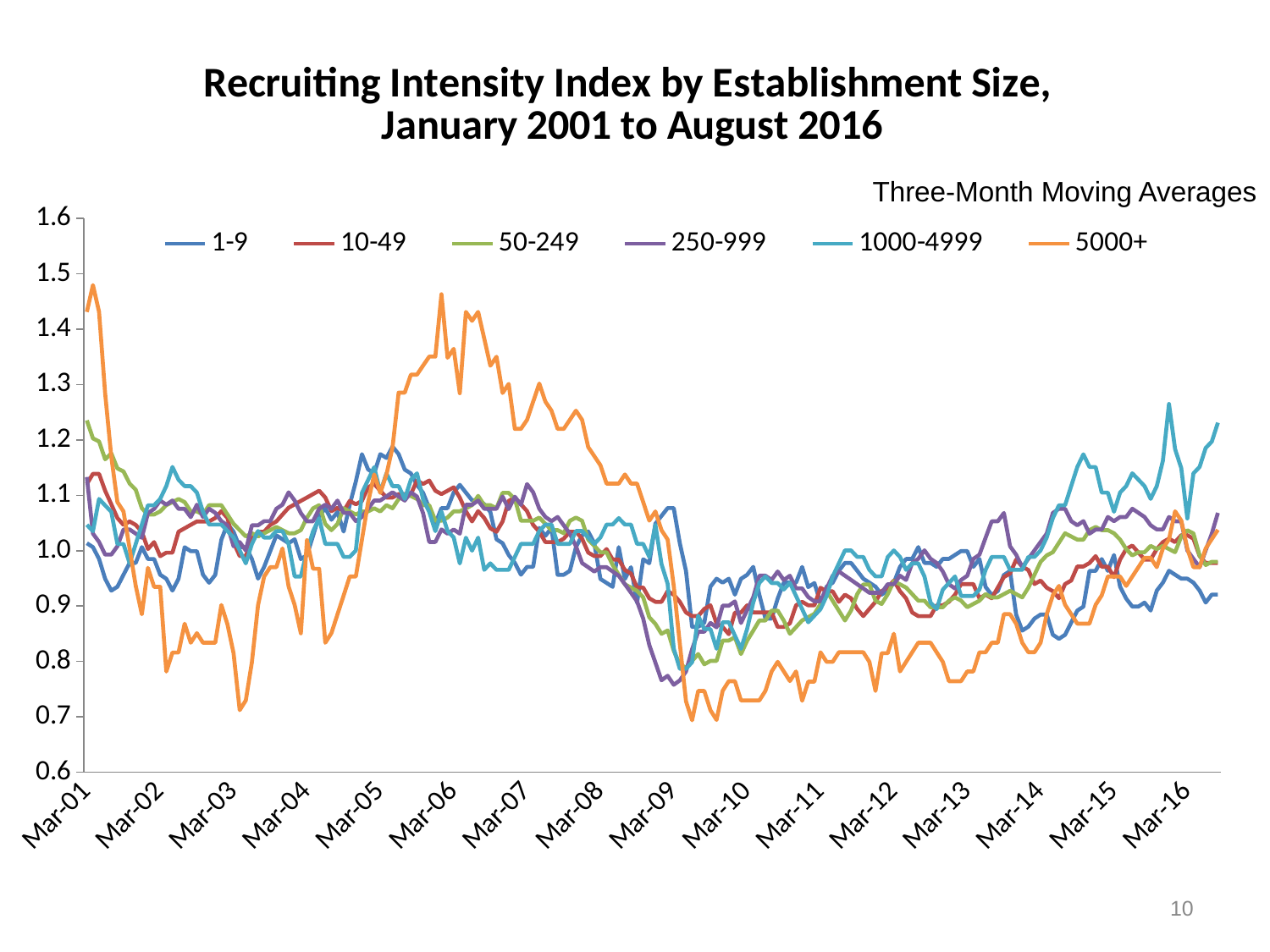
Which establishment size category is listed last in the legend? 5000+ What kind of chart is shown on the slide? line chart What is the title of the chart? Recruiting Intensity Index by Establishment Size, January 2001 to August 2016 Which series has the lowest value around Mar-10? 5000+ Is the value for the 250-999 series at Mar-09 greater or less than 0.9? less Is the value for the 5000+ series at Mar-10 greater or less than 0.8? less Is the value for the 5000+ series at Mar-06 greater or less than 1.3? greater At Mar-12, which is larger: the value for 10-49 or the value for 5000+? 10-49 How many series does the legend list? 6 Which series reaches the highest value anywhere on the chart? 5000+ Does the 5000+ series rise or fall between Mar-06 and Mar-09? fall